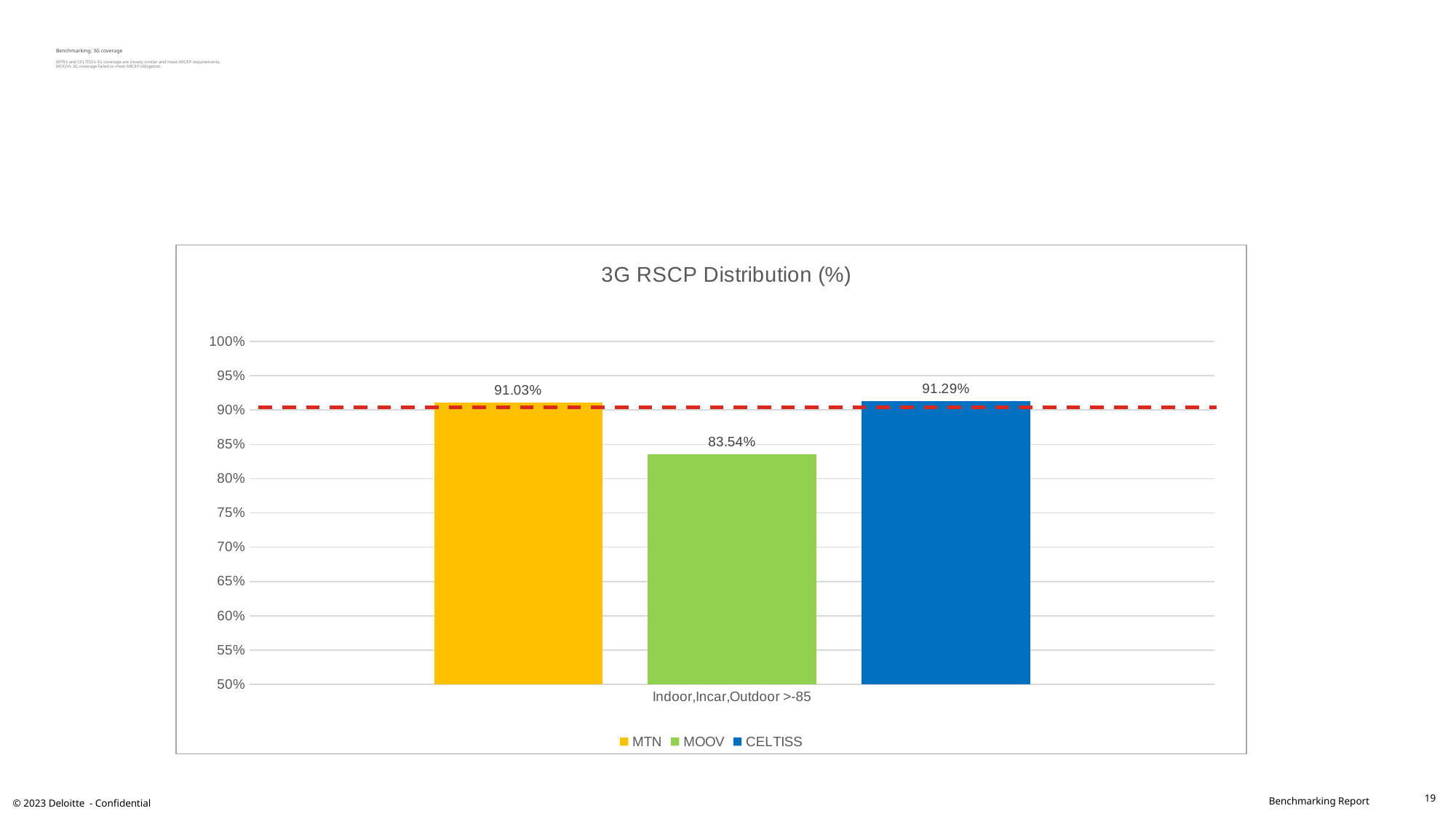
What is the value for CELTISS in the 3G RSCP Distribution chart? 91.29% Which operator has the lowest value in the 3G RSCP Distribution chart? MOOV Is the value for MOOV greater or less than 85%? less Is the value for MTN larger or smaller than the value for MOOV? larger How many series does the legend list in the 3G RSCP Distribution chart? 3 What is the difference between the CELTISS and MOOV values in the 3G RSCP Distribution chart? 7.75% What is the value for MOOV in the 3G RSCP Distribution chart? 83.54% What is the value for MTN in the 3G RSCP Distribution chart? 91.03% What type of chart is shown on the slide? Bar chart What is the difference between the MTN and MOOV values in the 3G RSCP Distribution chart? 7.49% What is the title of the chart on the slide? 3G RSCP Distribution (%) Which operator has the highest value in the 3G RSCP Distribution chart? CELTISS